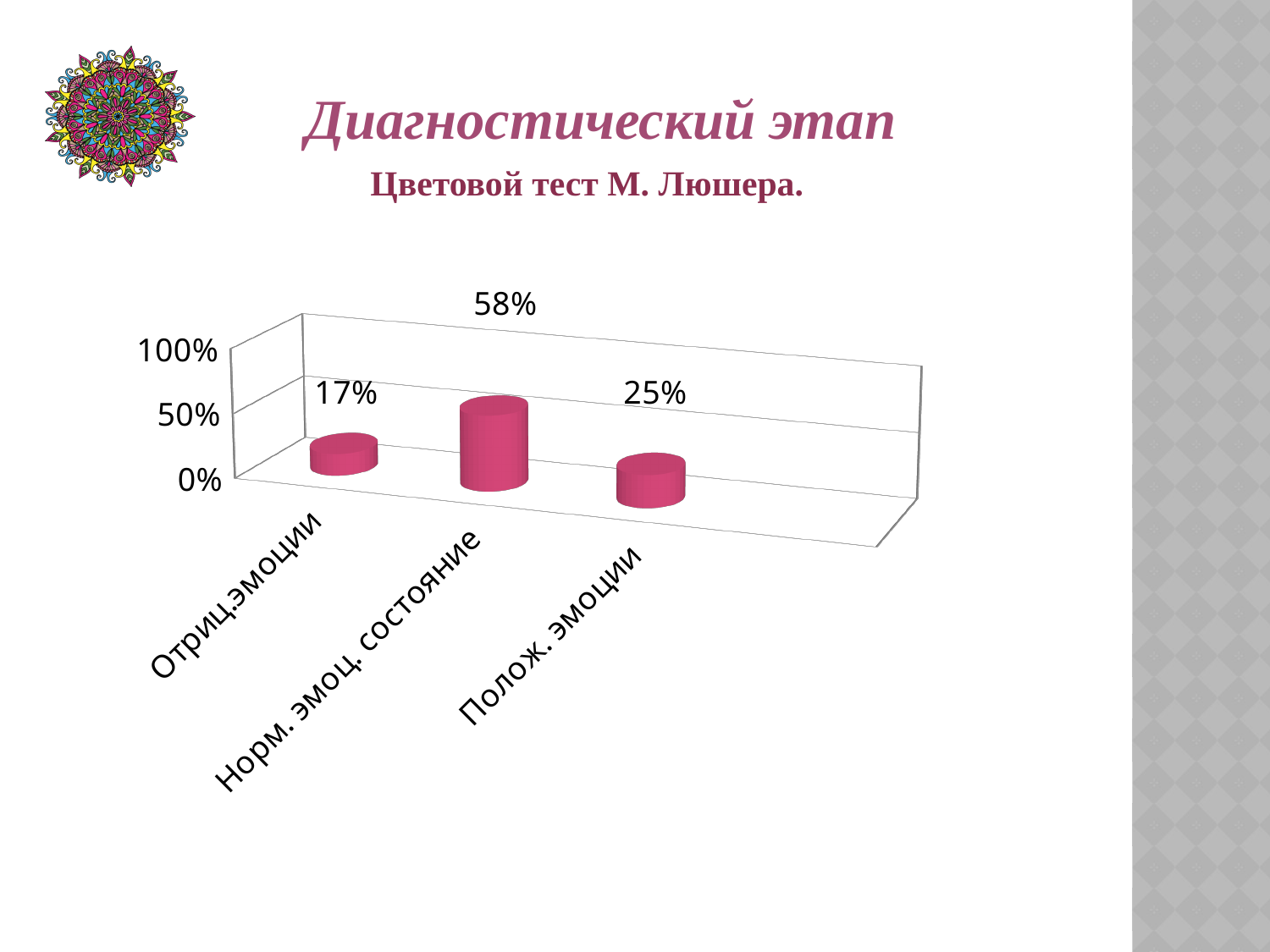
What is the subtitle shown above the chart? Цветовой тест М. Люшера. What is the value for Норм. эмоц. состояние? 58% Which category has the lowest value? Отриц.эмоции How many categories are shown on the chart? 3 Which is larger, the value for Полож. эмоции or the value for Отриц.эмоции? Полож. эмоции What is the difference between the values for Полож. эмоции and Отриц.эмоции? 8% What kind of chart is shown on the slide? bar chart What is the value for Отриц.эмоции? 17% What is the value for Полож. эмоции? 25% Is the value for Норм. эмоц. состояние greater or less than 50%? greater What is the difference between the values for Норм. эмоц. состояние and Полож. эмоции? 33% Which category has the highest value? Норм. эмоц. состояние